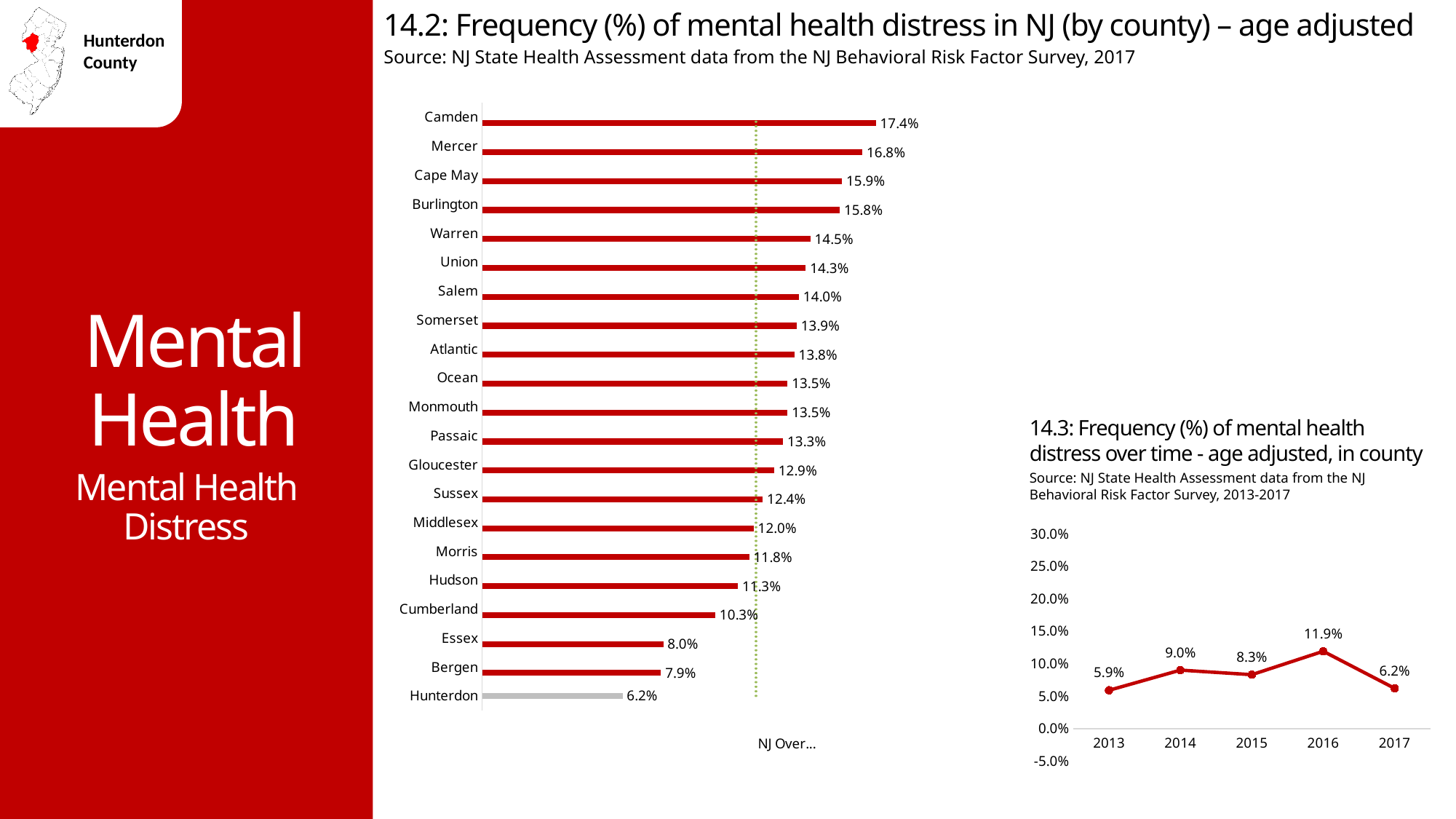
In chart 14.2, what is the value shown for Hunterdon? 6.2% In chart 14.3, what is the value for 2016? 11.9% In chart 14.2, what is the frequency of mental health distress for Camden? 17.4% In chart 14.2, what is the difference between the values for Camden and Hunterdon? 11.2% In chart 14.3, what is the difference between the values for 2016 and 2017? 5.7% In chart 14.2, which has a higher value, Essex or Cumberland? Cumberland In chart 14.2, which county has the highest frequency of mental health distress? Camden In chart 14.3, which year has the highest value? 2016 In chart 14.2, which county has the lowest frequency of mental health distress? Hunterdon In chart 14.2, how many counties are plotted? 21 In chart 14.3, how many years are plotted? 5 What kind of chart is chart 14.2? Bar chart